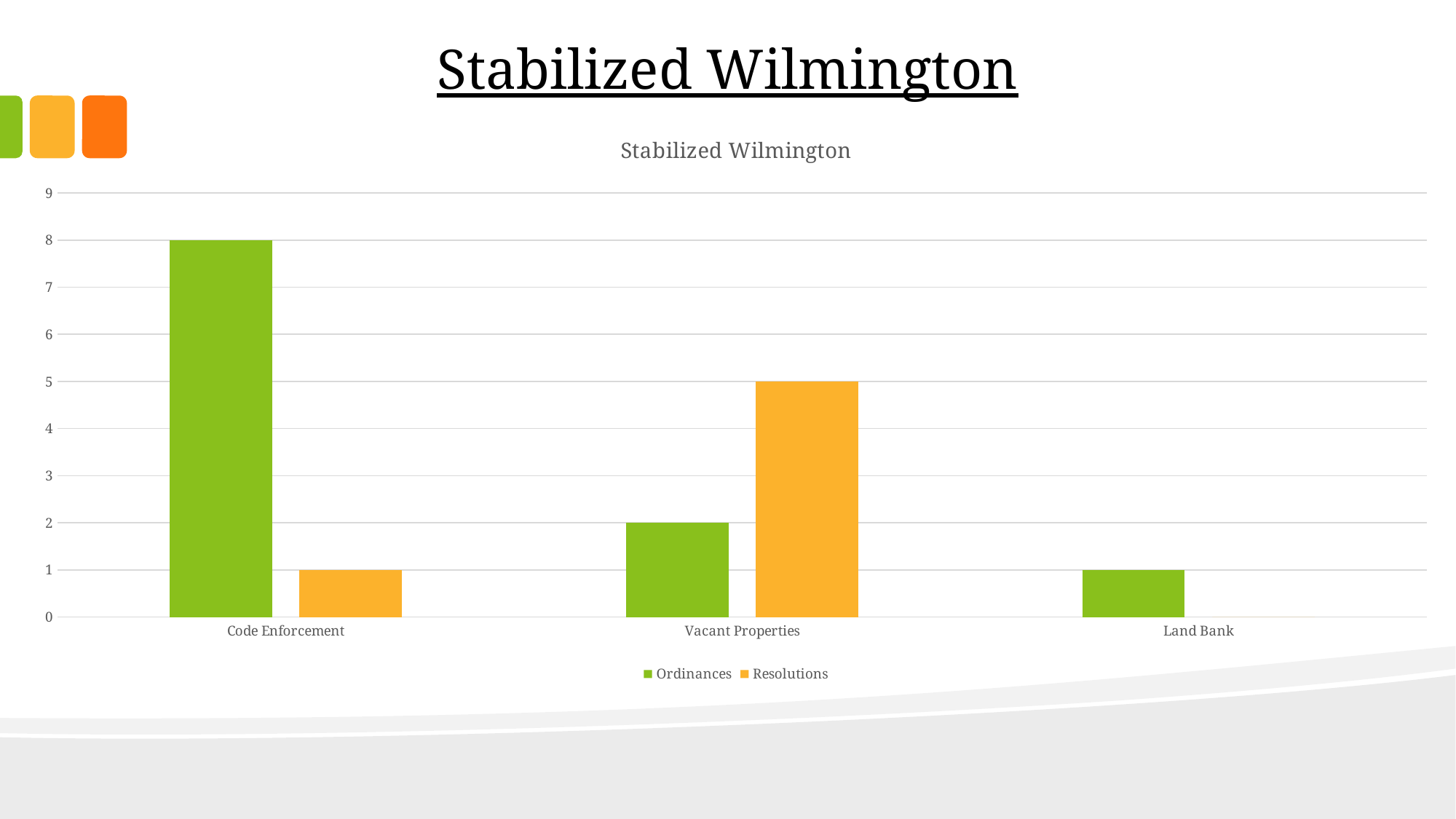
What is the Resolutions value for Vacant Properties? 5 What is the difference between the Ordinances and Resolutions values for Code Enforcement? 7 What is the title of the chart? Stabilized Wilmington What is the Ordinances value for Code Enforcement? 8 Which category has the lowest Ordinances value? Land Bank How many series does the legend list? 2 What is the Ordinances value for Land Bank? 1 Which category has the highest Ordinances value? Code Enforcement Which series is shown in green? Ordinances How many categories are shown on the x axis? 3 For Vacant Properties, which is larger: Ordinances or Resolutions? Resolutions What type of chart is shown on the slide? bar chart